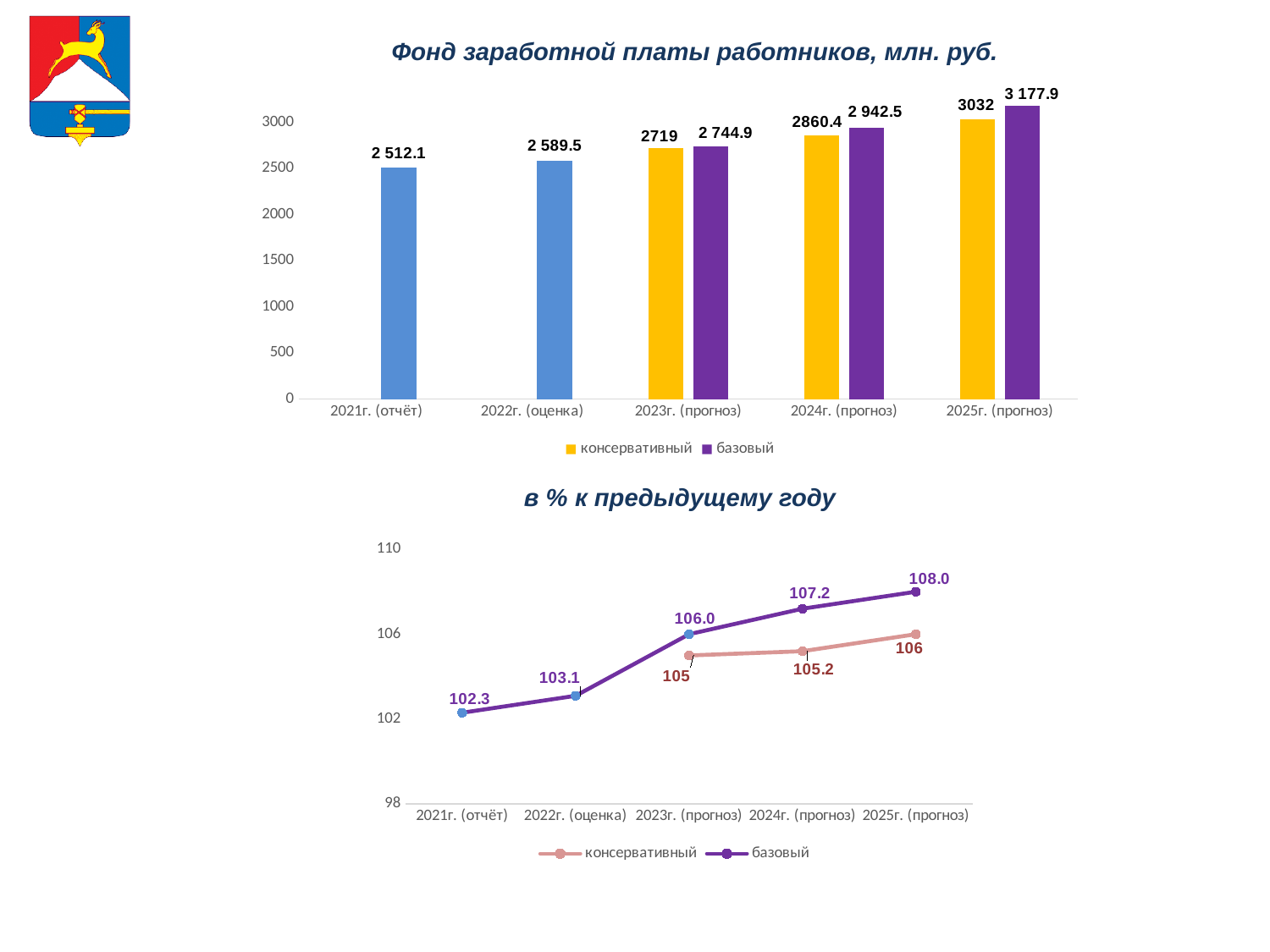
In the chart titled 'Фонд заработной платы работников, млн. руб.', what is the базовый value for 2025г. (прогноз)? 3 177.9 In the chart titled 'в % к предыдущему году', which series has the larger value for 2025г. (прогноз), консервативный or базовый? базовый In the chart titled 'Фонд заработной платы работников, млн. руб.', what is the консервативный value for 2024г. (прогноз)? 2860.4 In the chart titled 'Фонд заработной платы работников, млн. руб.', how many series does the legend list? 2 In the chart titled 'Фонд заработной платы работников, млн. руб.', what is the value for 2021г. (отчёт)? 2 512.1 In the chart titled 'в % к предыдущему году', what is the консервативный value for 2023г. (прогноз)? 105 In the chart titled 'в % к предыдущему году', what is the базовый value for 2024г. (прогноз)? 107.2 In the chart titled 'в % к предыдущему году', do the базовый values rise or fall from 2021г. (отчёт) to 2025г. (прогноз)? rise In the chart titled 'Фонд заработной платы работников, млн. руб.', which year has the lowest value? 2021г. (отчёт) In the chart titled 'Фонд заработной платы работников, млн. руб.', what is the difference between the базовый and консервативный values for 2025г. (прогноз)? 145.9 What kind of chart is the bottom chart titled 'в % к предыдущему году'? line chart What kind of chart is the top chart titled 'Фонд заработной платы работников, млн. руб.'? bar chart